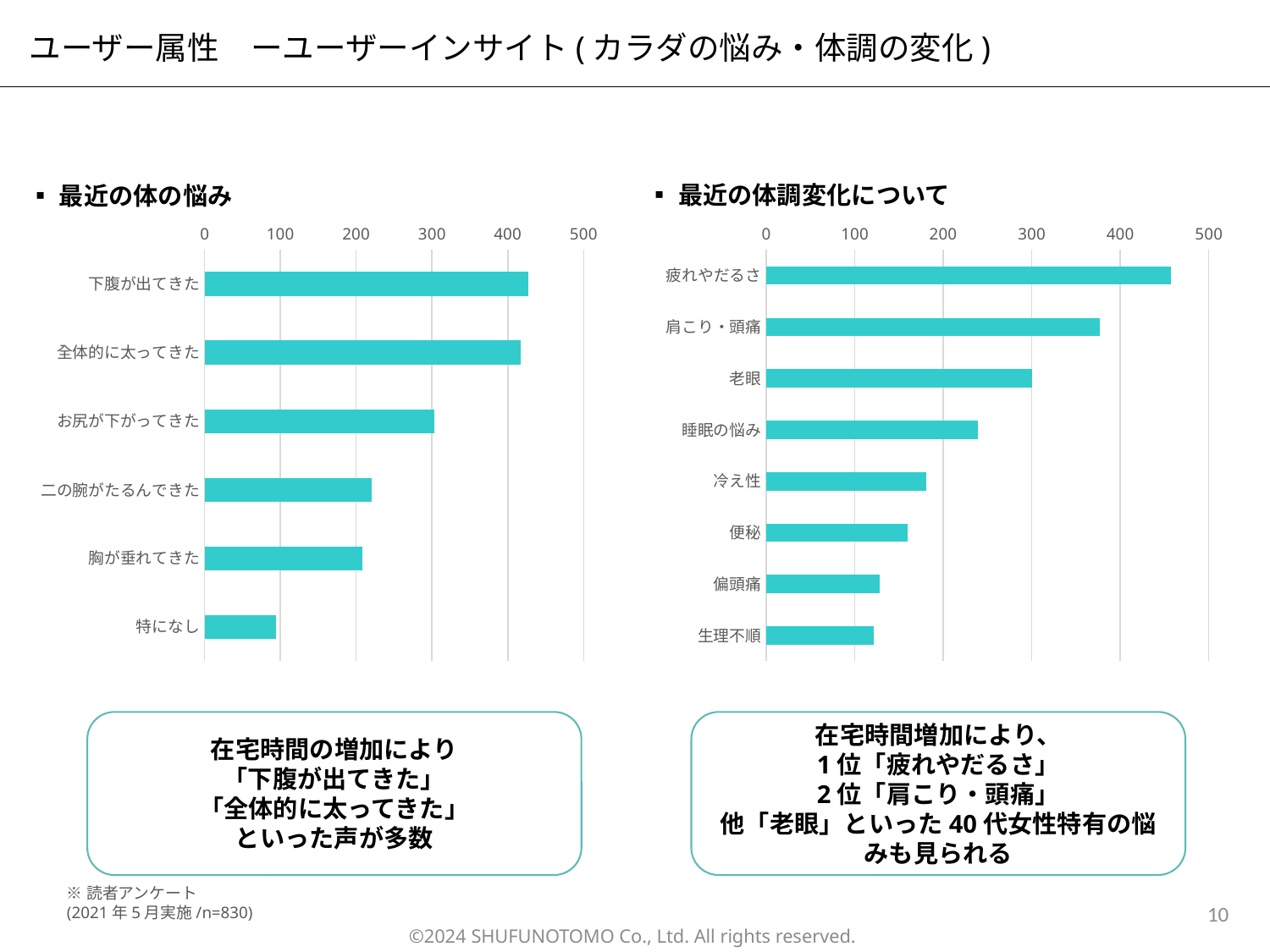
In the left chart (最近の体の悩み), how many categories are shown? 6 In the right chart (最近の体調変化について), which is larger, the value for 老眼 or the value for 睡眠の悩み? 老眼 In the right chart (最近の体調変化について), which is larger, the value for 冷え性 or the value for 便秘? 冷え性 In the right chart (最近の体調変化について), how many categories are shown? 8 In the left chart (最近の体の悩み), is the value for 下腹が出てきた greater or less than 400? greater In the left chart (最近の体の悩み), is the value for 特になし greater or less than 100? less In the left chart (最近の体の悩み), which category has the lowest value? 特になし In the right chart (最近の体調変化について), which category has the highest value? 疲れやだるさ In the right chart (最近の体調変化について), is the value for 睡眠の悩み greater or less than 200? greater What is the title of the chart on the right side of the slide? 最近の体調変化について What kind of chart is the left chart titled 最近の体の悩み? bar chart